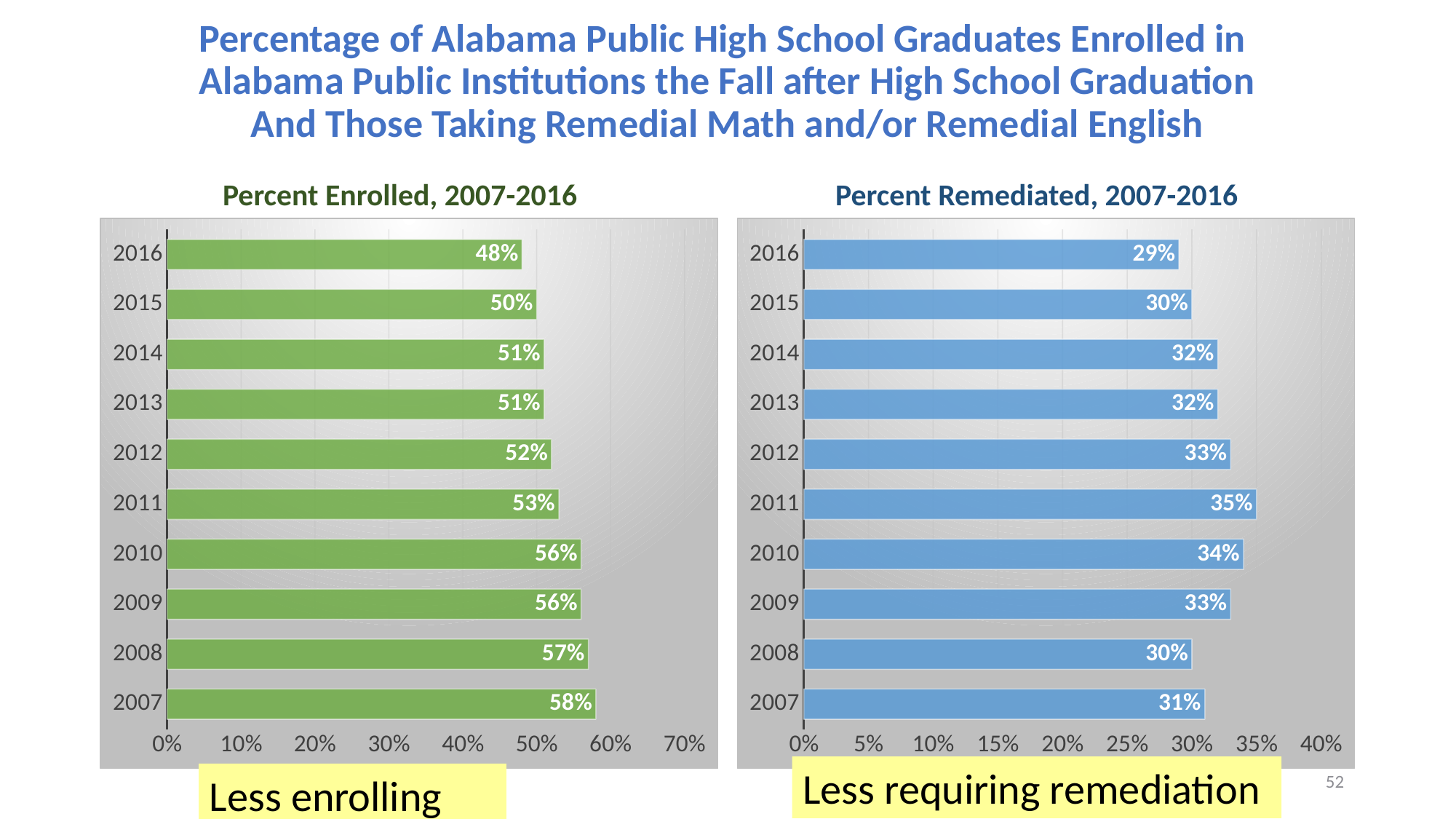
How many years are shown in the 'Percent Enrolled, 2007-2016' chart? 10 In the 'Percent Remediated, 2007-2016' chart, is the value for 2008 greater or less than 35%? less What colour are the bars in the 'Percent Remediated, 2007-2016' chart? blue In the 'Percent Enrolled, 2007-2016' chart, what is the difference between the values for 2007 and 2016? 10% In the 'Percent Remediated, 2007-2016' chart, which year has the lowest value? 2016 In the 'Percent Enrolled, 2007-2016' chart, what is the value for 2016? 48% In the 'Percent Remediated, 2007-2016' chart, what is the value for 2011? 35% In the 'Percent Enrolled, 2007-2016' chart, do the values rise or fall from 2007 to 2016? fall In the 'Percent Enrolled, 2007-2016' chart, which is larger, the value for 2010 or the value for 2012? 2010 In the 'Percent Enrolled, 2007-2016' chart, which year has the highest value? 2007 What kind of chart is the 'Percent Remediated, 2007-2016' chart? bar chart In the 'Percent Remediated, 2007-2016' chart, what is the difference between the values for 2011 and 2016? 6%